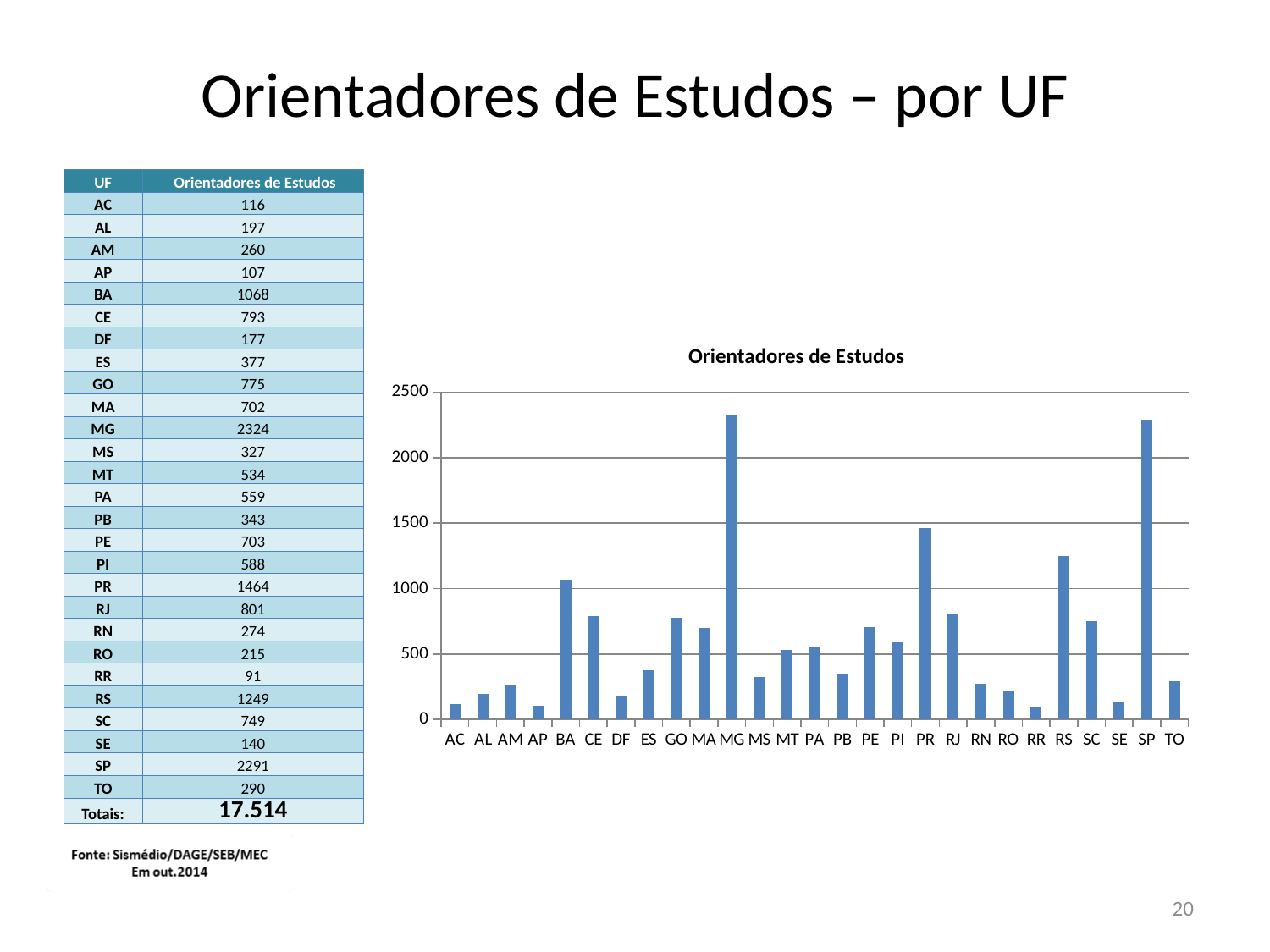
Is the value for BA greater or less than 1000? greater What type of chart is shown on the slide? bar chart Which UF has the lowest number of Orientadores de Estudos? RR What is the difference between the values for PR and RS? 215 What is the value for SP? 2291 What is the value for MG? 2324 Which is larger, the value for BA or the value for CE? BA Is the value for RS greater or less than 1500? less What is the value for PR? 1464 Which UF has the highest number of Orientadores de Estudos? MG What is the title of the chart? Orientadores de Estudos How many UF categories are plotted on the x axis of the chart? 27